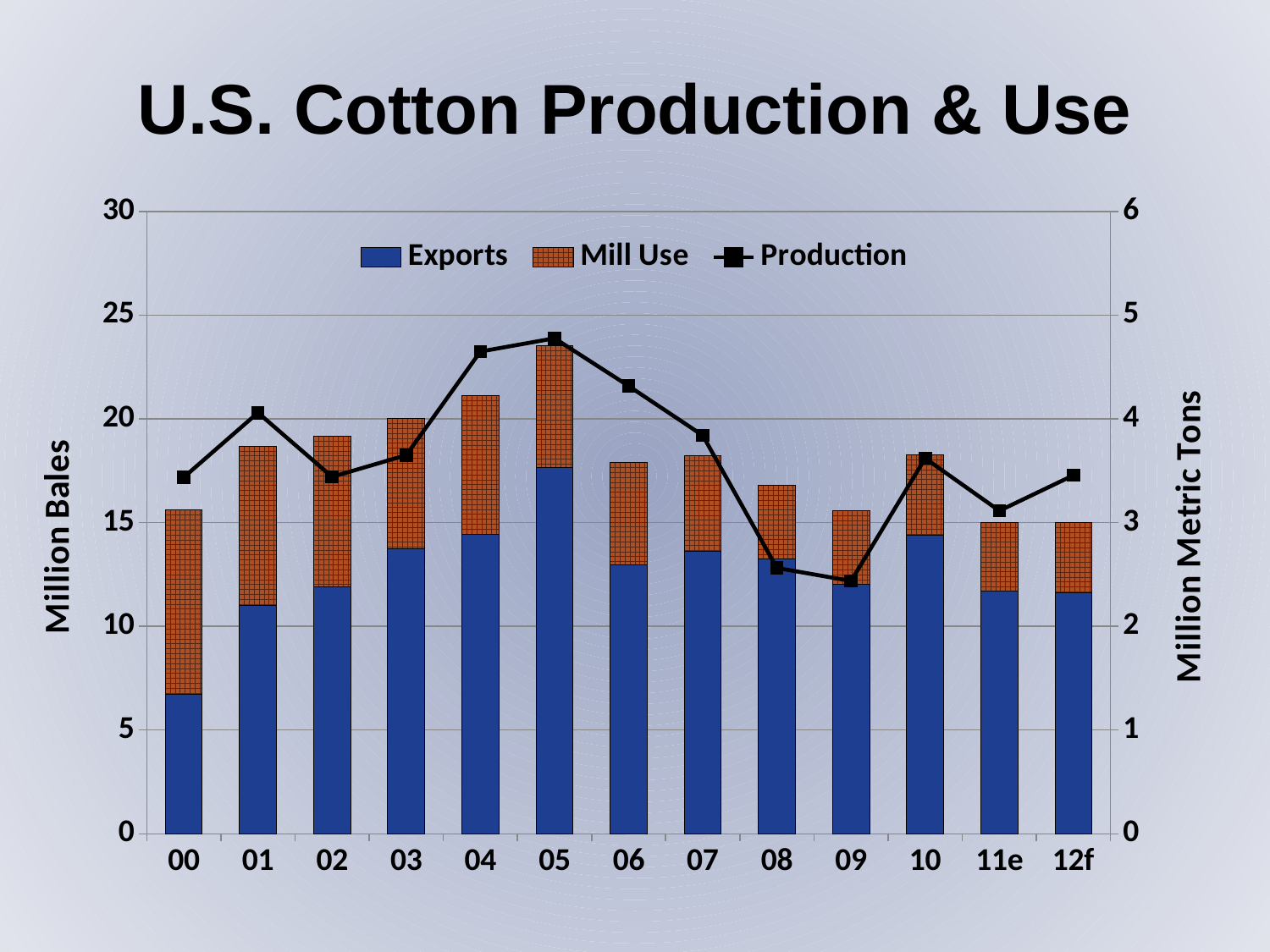
Which year has the highest Exports value? 05 Does the Production line rise or fall from 05 to 09? fall Which year has the larger Exports value, 01 or 04? 04 Which year has the lowest Production value? 09 Is the Exports value for 05 greater or less than 15 million bales? greater How many series does the legend list? 3 How many years are shown along the x axis? 13 Which year has the tallest stacked bar (Exports plus Mill Use)? 05 Is the Exports value for 00 greater or less than 10 million bales? less What kind of chart is shown on the slide? bar chart with a line Which year has the lowest Exports value? 00 Is the Production value for 09 greater or less than 3 million metric tons? less